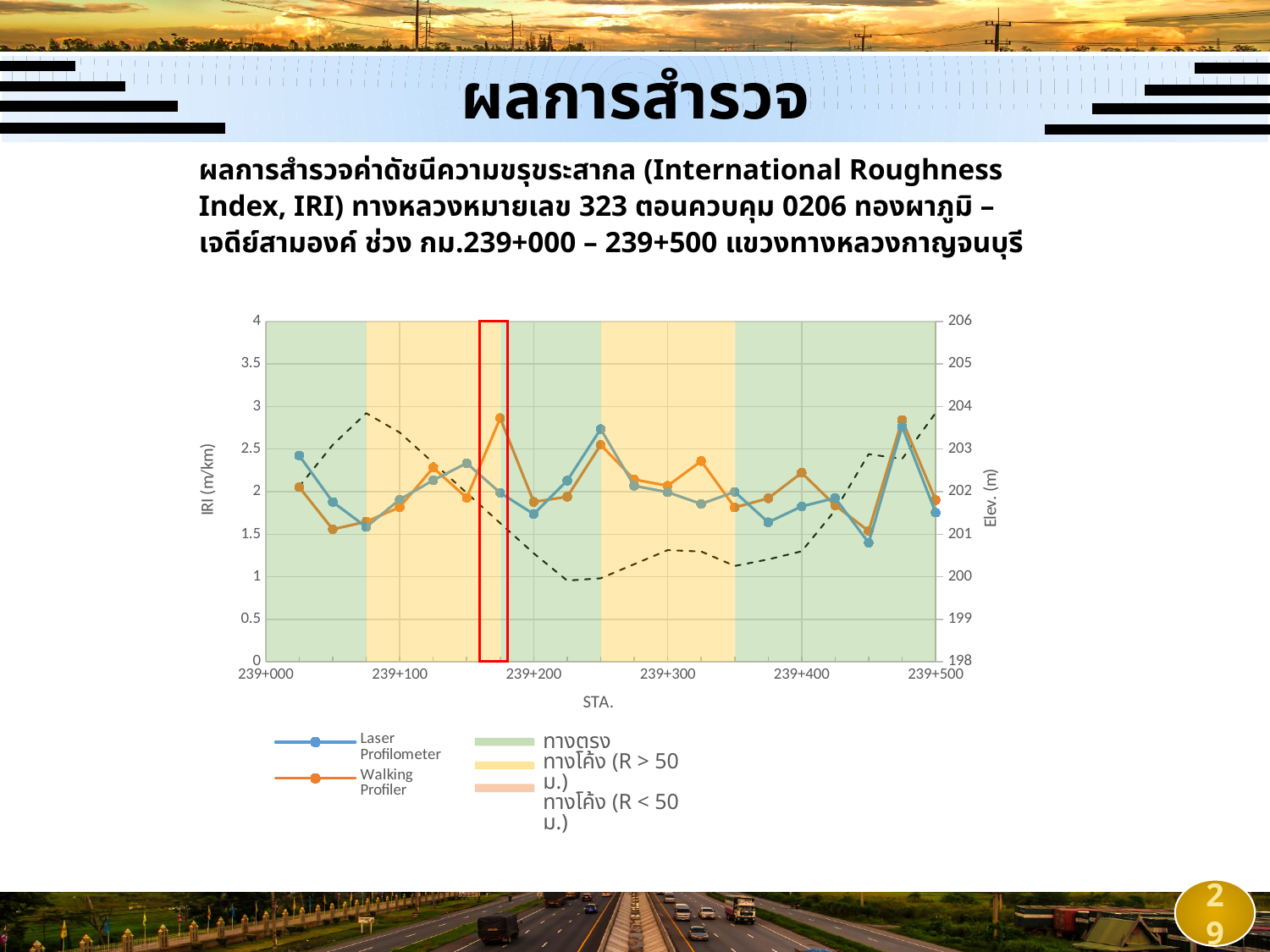
At the station highlighted by the red box (around 239+175), which series has the higher IRI value, Laser Profilometer or Walking Profiler? Walking Profiler Is the Laser Profilometer value at station 239+250 greater or less than 2.5? greater What is the label of the left vertical axis? IRI (m/km) Is the Laser Profilometer value at station 239+450 greater or less than 1.5? less At station 239+025, which series has the higher IRI value, Laser Profilometer or Walking Profiler? Laser Profilometer What is the label of the right vertical axis? Elev. (m) At which station does the Laser Profilometer series reach its lowest IRI value? 239+450 What kind of chart is shown on the slide? line chart Is the Laser Profilometer value at station 239+025 greater or less than 2? greater How many line series (profiler measurements) does the legend list? 2 What is the maximum value shown on the left IRI axis? 4